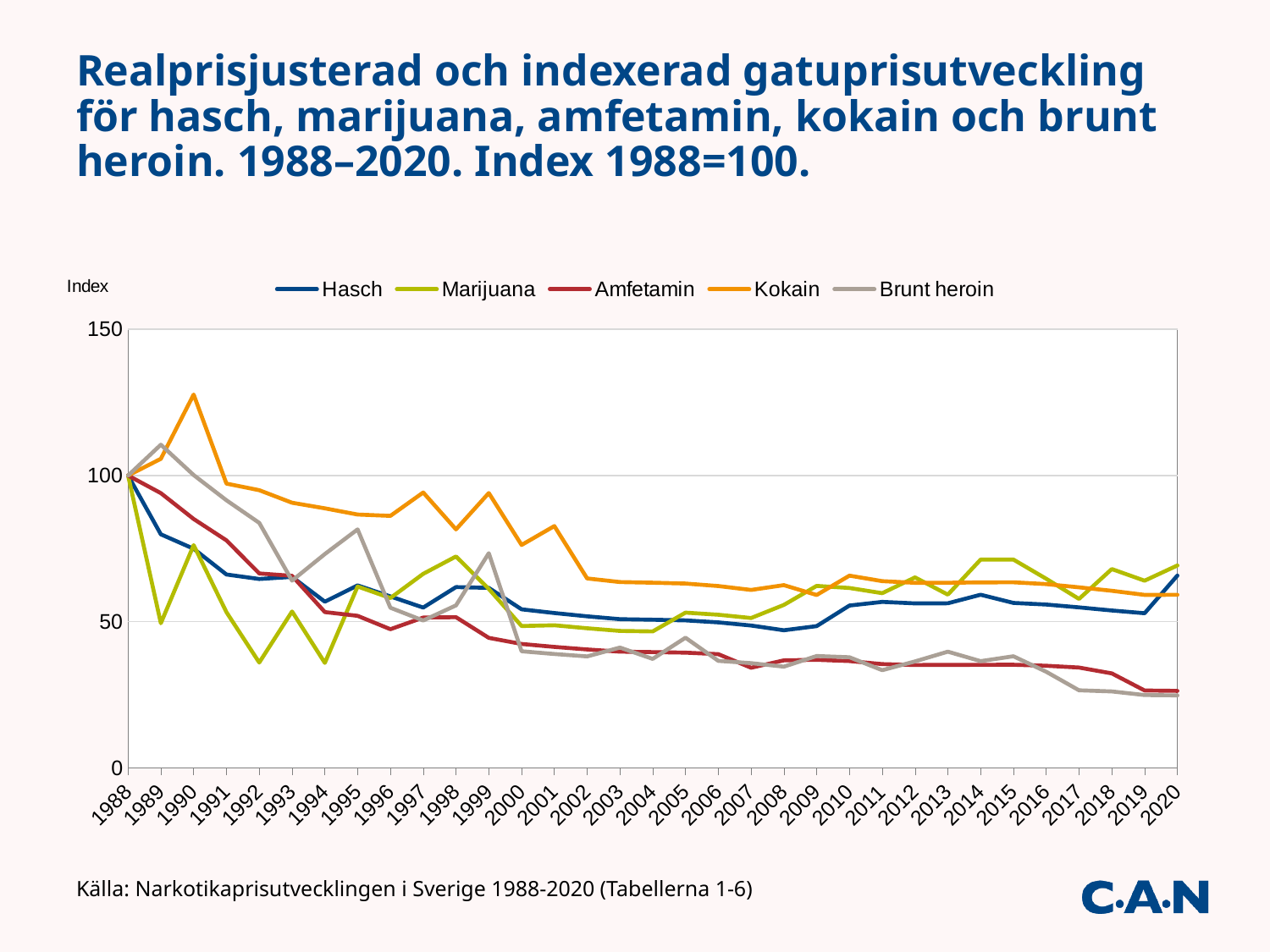
Which series has the lowest value in 1992? Marijuana Is the value for Amfetamin in 2020 greater or less than 50? less How many years are plotted along the x axis? 33 What is the index value for all series in 1988? 100 Is the value for Hasch in 2020 greater or less than 50? greater How many series does the legend list? 5 Which series has the highest value in 1990? Kokain What kind of chart is shown on the slide? Line chart Is the value for Kokain in 1990 greater or less than 100? greater Does the Amfetamin series rise or fall overall from 1988 to 2020? Fall In 2010, which is larger: the value for Kokain or the value for Brunt heroin? Kokain